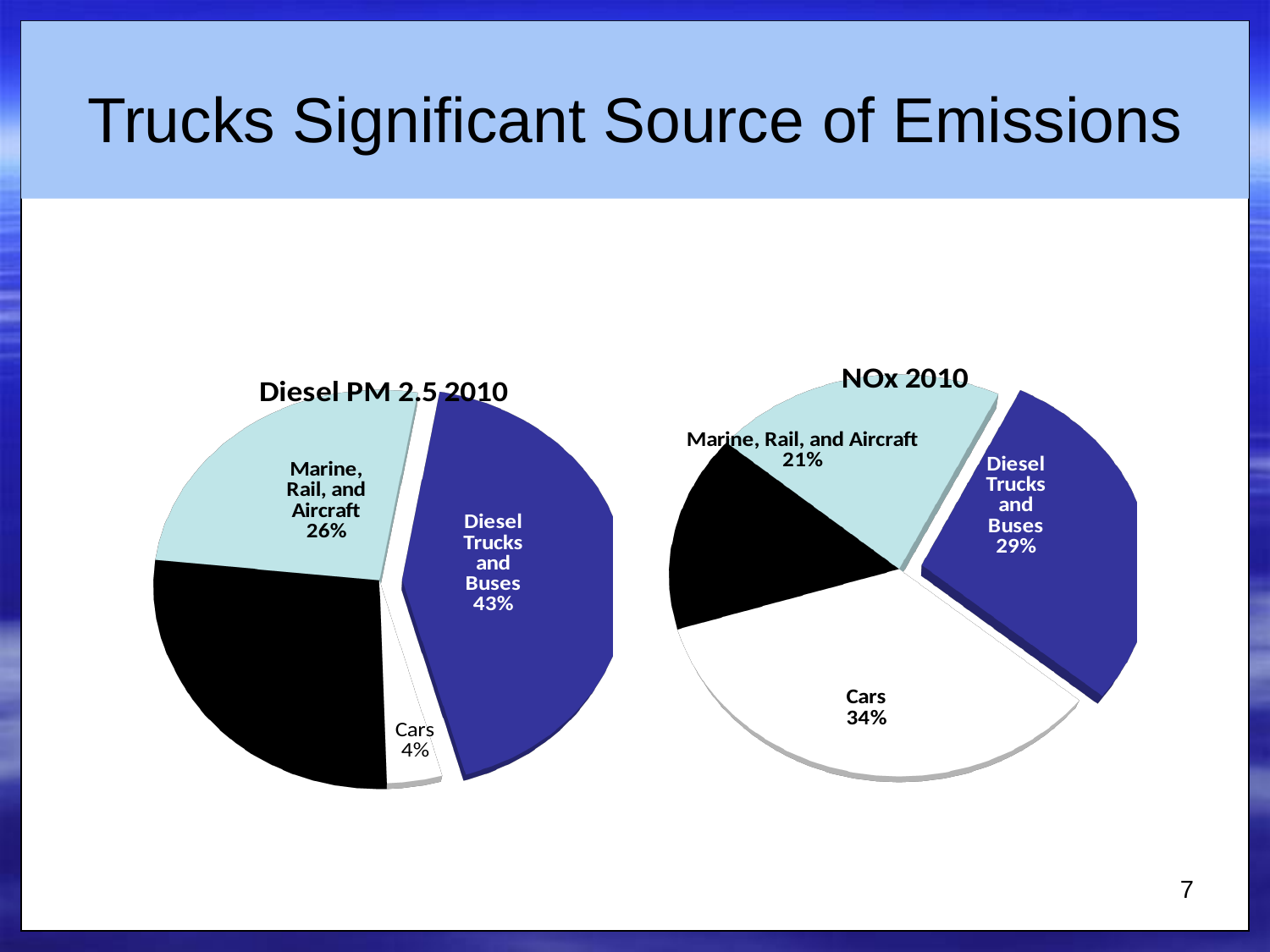
In the Diesel PM 2.5 2010 chart, how many percentage points larger is the Diesel Trucks and Buses share than the Marine, Rail, and Aircraft share? 17 percentage points What kind of chart is the NOx 2010 chart? Pie chart In the NOx 2010 chart, what share do Marine, Rail, and Aircraft account for? 21% How many slices does the Diesel PM 2.5 2010 pie chart have? 4 In the NOx 2010 chart, which is larger: the share for Diesel Trucks and Buses or the share for Marine, Rail, and Aircraft? Diesel Trucks and Buses In the NOx 2010 chart, how many percentage points larger is the Cars share than the Diesel Trucks and Buses share? 5 percentage points In the Diesel PM 2.5 2010 chart, what share do Diesel Trucks and Buses account for? 43% In the NOx 2010 chart, which labeled category has the largest share? Cars In the NOx 2010 chart, what share do Cars account for? 34% In the Diesel PM 2.5 2010 chart, which category has the smallest share? Cars In the Diesel PM 2.5 2010 chart, what share do Cars account for? 4% In the Diesel PM 2.5 2010 chart, which labeled category has the largest share? Diesel Trucks and Buses